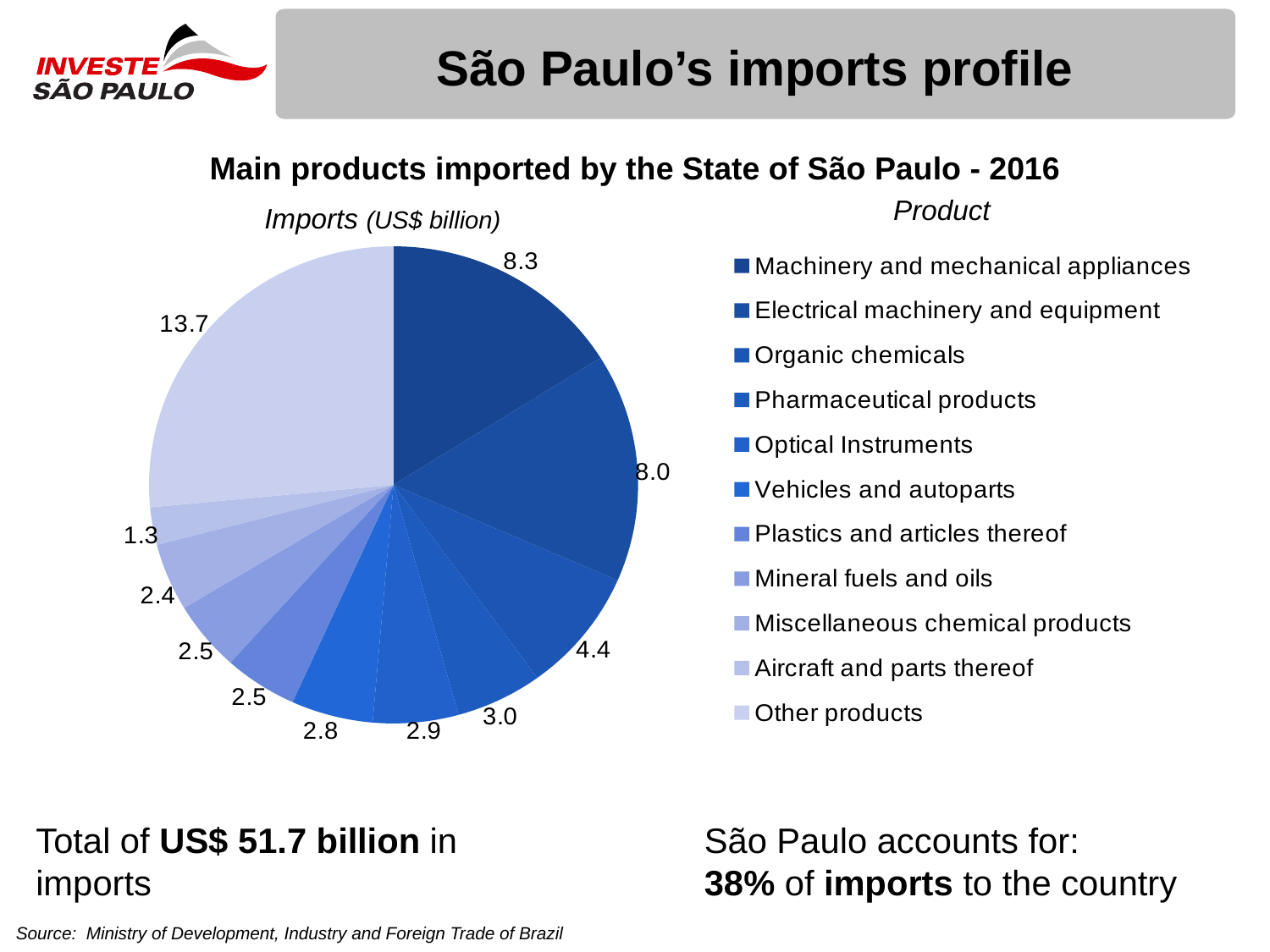
What is the import value (US$ billion) for Machinery and mechanical appliances? 8.3 What is the value of the smallest slice in the pie chart? 1.3 What is the import value (US$ billion) for Electrical machinery and equipment? 8.0 Which is larger: the slice for Organic chemicals or the slice for Pharmaceutical products? Organic chemicals What is the import value (US$ billion) for Organic chemicals? 4.4 Which product category has the smallest slice in the pie chart? Aircraft and parts thereof What is the value of the largest slice in the pie chart? 13.7 Which product category has the largest slice in the pie chart? Other products How many product categories does the legend of the pie chart list? 11 What is the title of the chart? Main products imported by the State of São Paulo - 2016 What type of chart is shown on the slide? Pie chart What is the difference between the Machinery and mechanical appliances slice (8.3) and the Electrical machinery and equipment slice (8.0)? 0.3